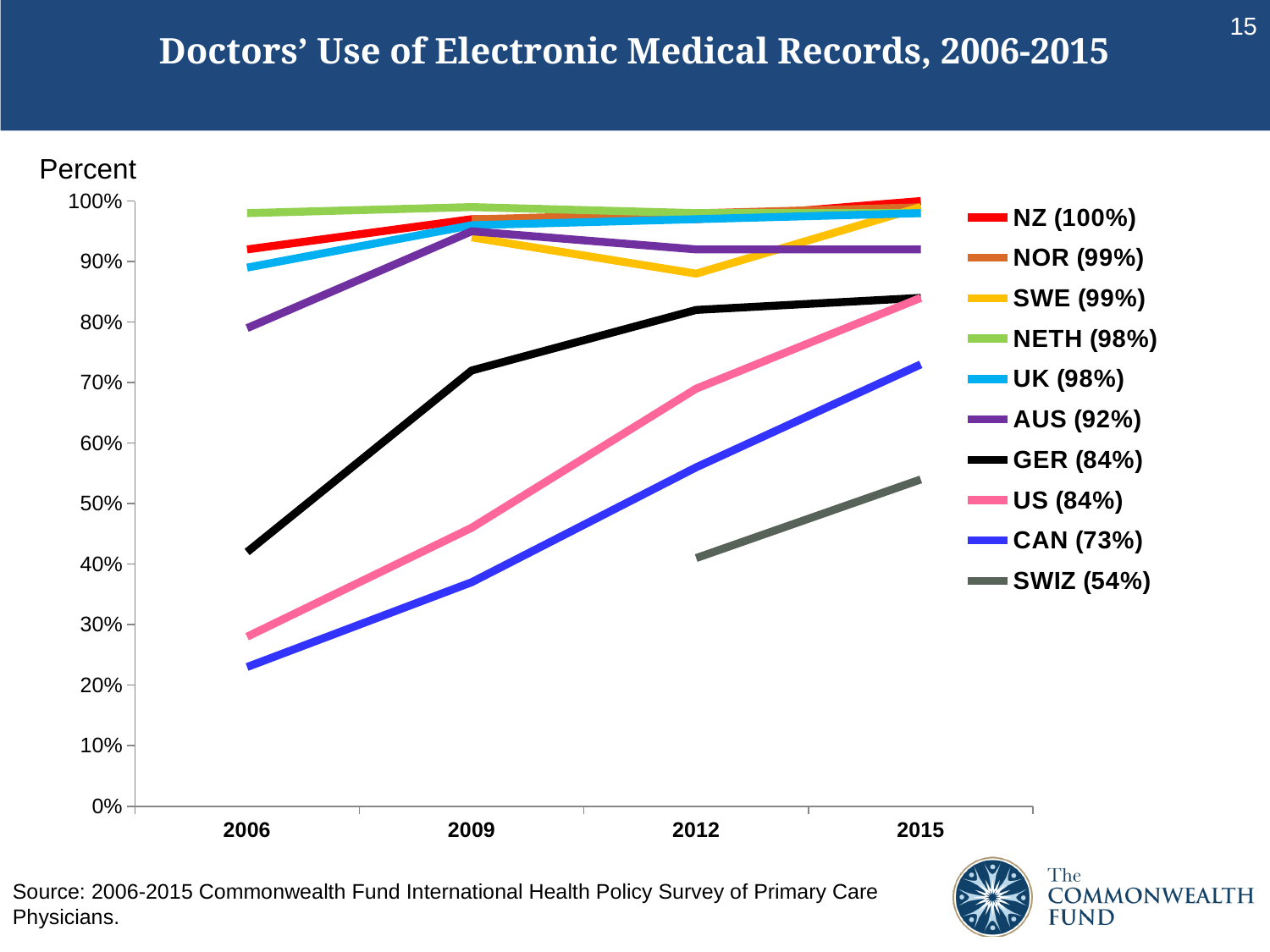
How many years are shown on the x axis? 4 Does the CAN line rise or fall from 2006 to 2015? Rise What is the 2015 value for NZ, as shown in the legend? 100% What is the difference between the 2015 values for AUS and CAN? 19 percentage points Which country has the lowest value in 2015? SWIZ Which has the larger 2015 value, GER or CAN? GER What is the 2015 value for CAN, as shown in the legend? 73% Which country has the highest value in 2015? NZ Is the value for CAN in 2006 greater or less than 30%? less What kind of chart is shown on the slide? Line chart What is the 2015 value for SWIZ, as shown in the legend? 54% How many series does the legend list? 10